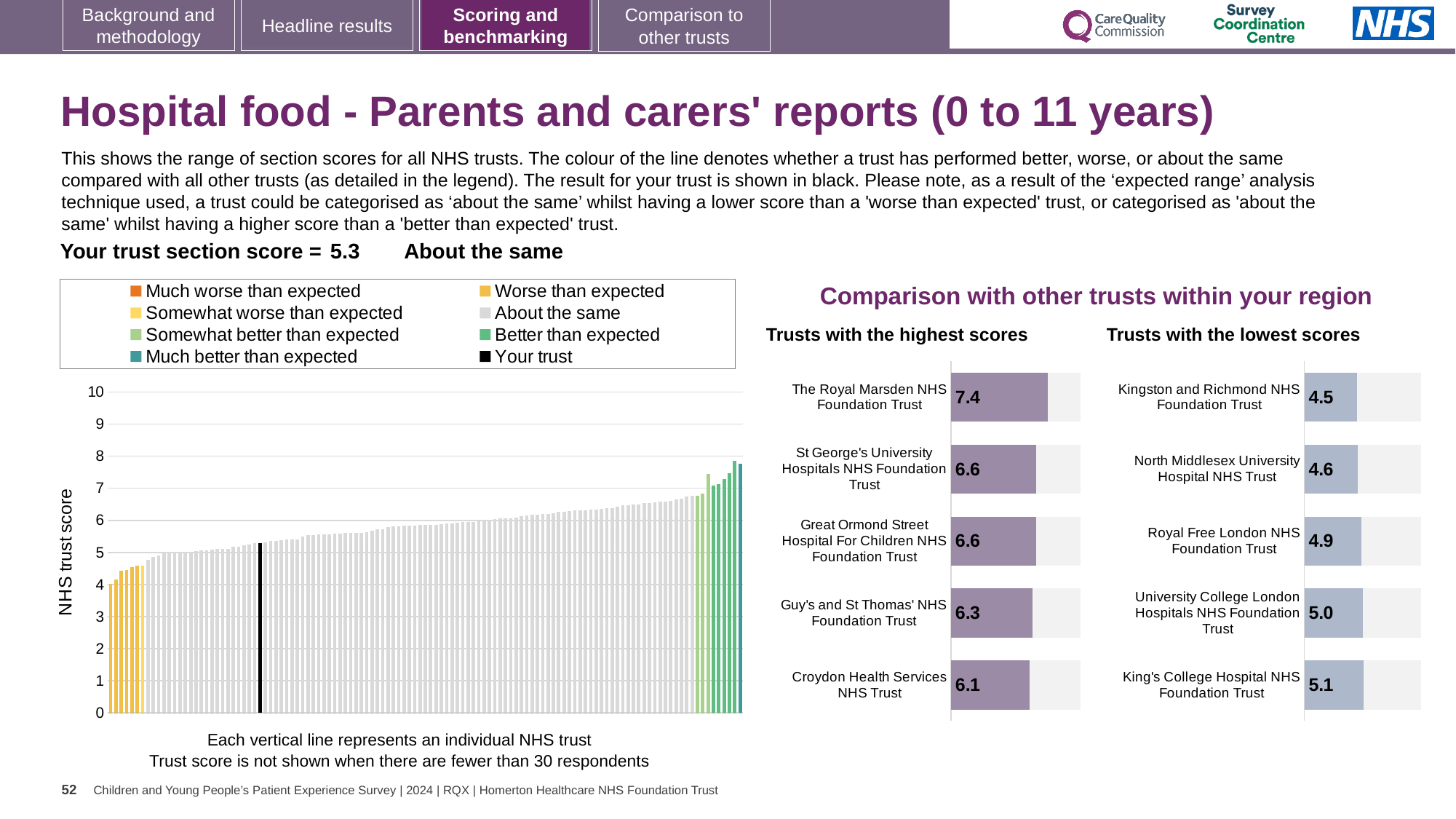
In the main chart on the left, is the value of the tallest bar greater or less than 7? greater How many trusts are shown in the 'Trusts with the lowest scores' chart? 5 In the 'Trusts with the lowest scores' chart, what is the difference between the scores of King's College Hospital NHS Foundation Trust and Kingston and Richmond NHS Foundation Trust? 0.6 In the 'Trusts with the highest scores' chart, what is the score for The Royal Marsden NHS Foundation Trust? 7.4 In the 'Trusts with the highest scores' chart, which trust has the lowest score? Croydon Health Services NHS Trust In the 'Trusts with the highest scores' chart, which has the larger score: Guy's and St Thomas' NHS Foundation Trust or Croydon Health Services NHS Trust? Guy's and St Thomas' NHS Foundation Trust In the 'Trusts with the highest scores' chart, what is the difference between the scores of The Royal Marsden NHS Foundation Trust and Croydon Health Services NHS Trust? 1.3 How many entries does the legend of the main chart on the left list? 8 In the 'Trusts with the lowest scores' chart, which trust has the highest score? King's College Hospital NHS Foundation Trust In the 'Trusts with the lowest scores' chart, which trust has the lowest score? Kingston and Richmond NHS Foundation Trust In the 'Trusts with the lowest scores' chart, what is the score for Royal Free London NHS Foundation Trust? 4.9 In the main chart on the left showing all NHS trusts, what is the section score for your trust (the black bar)? 5.3